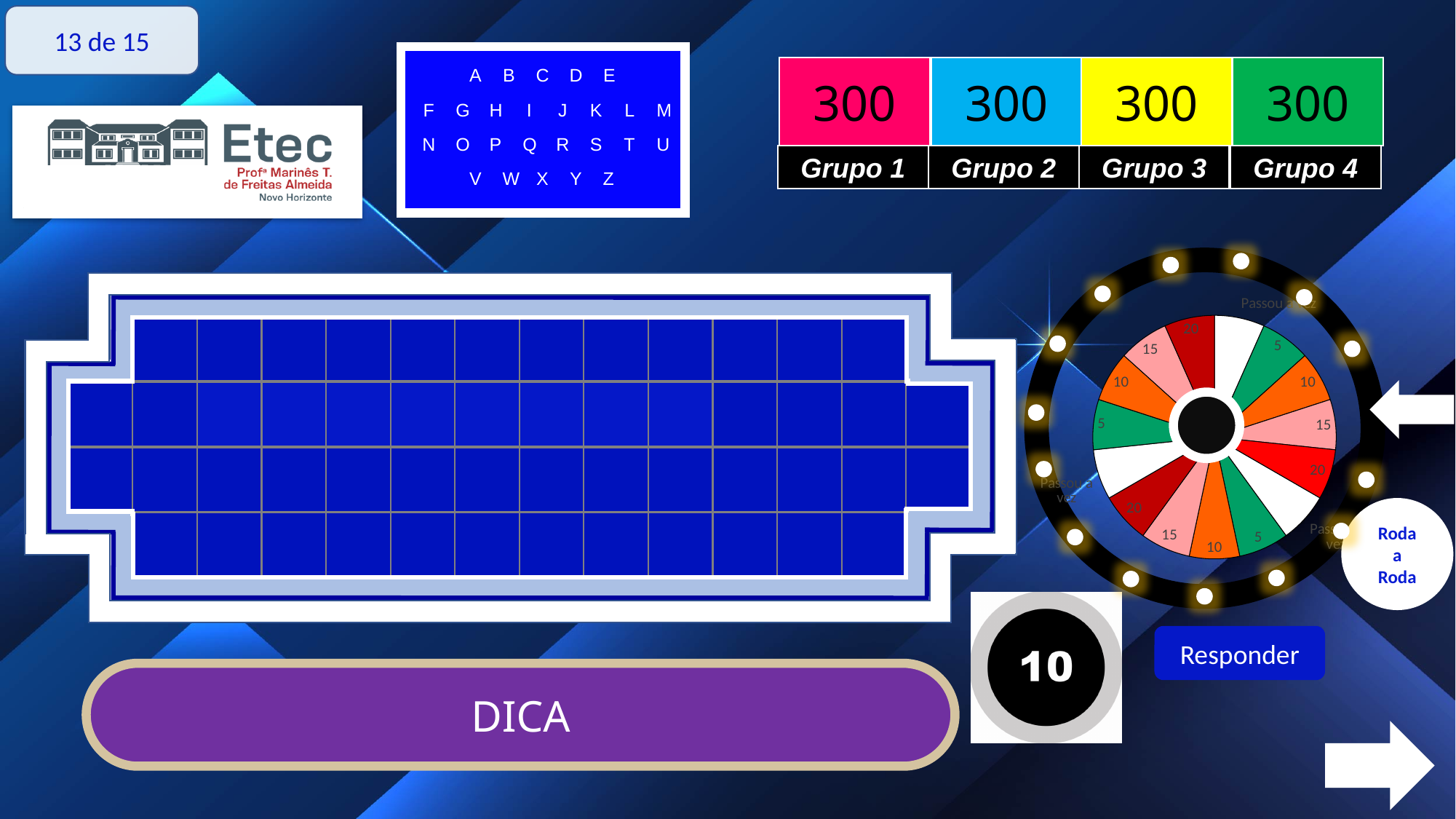
Which is larger, the number on a red segment of the wheel or the number on a green segment? red segment What colour are the wheel segments labelled 5? green What is the difference between the number on a red segment and the number on a green segment of the wheel? 15 What kind of chart is the wheel on the right side of the slide? pie chart What is the highest number printed on any segment of the wheel? 20 What is the lowest number printed on any segment of the wheel? 5 What colour are the wheel segments labelled 20? red